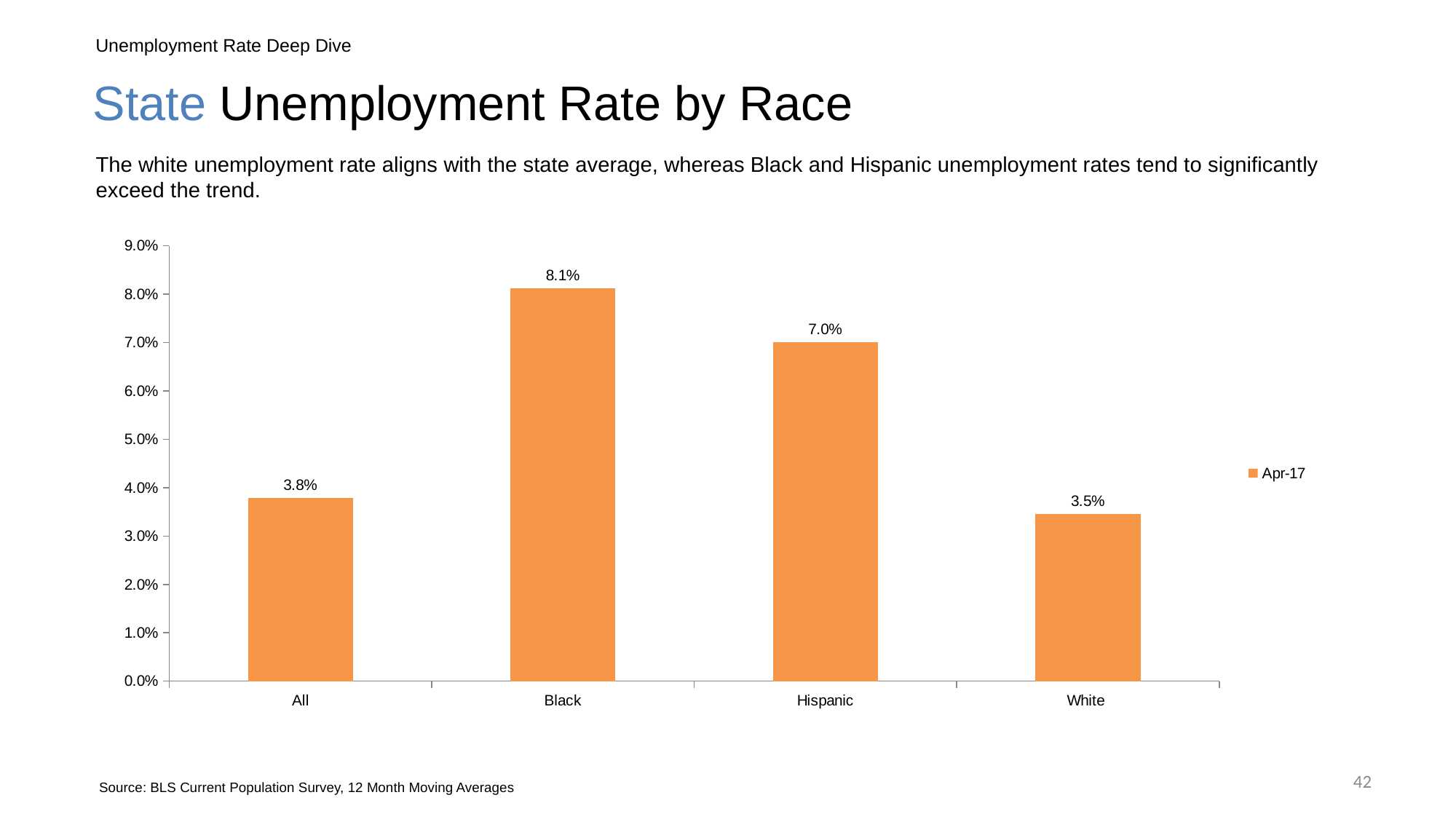
How many categories are shown on the x axis? 4 What series does the legend list? Apr-17 What is the unemployment rate for White? 3.5% Which is larger, the unemployment rate for Hispanic or for All? Hispanic Is the value for Hispanic greater or less than 5.0%? greater What is the unemployment rate for Black? 8.1% Which category has the highest unemployment rate? Black What is the unemployment rate for All? 3.8% What is the difference between the Black and White unemployment rates? 4.6% What kind of chart is shown on the slide? Bar chart Which category has the lowest unemployment rate? White What is the unemployment rate for Hispanic? 7.0%